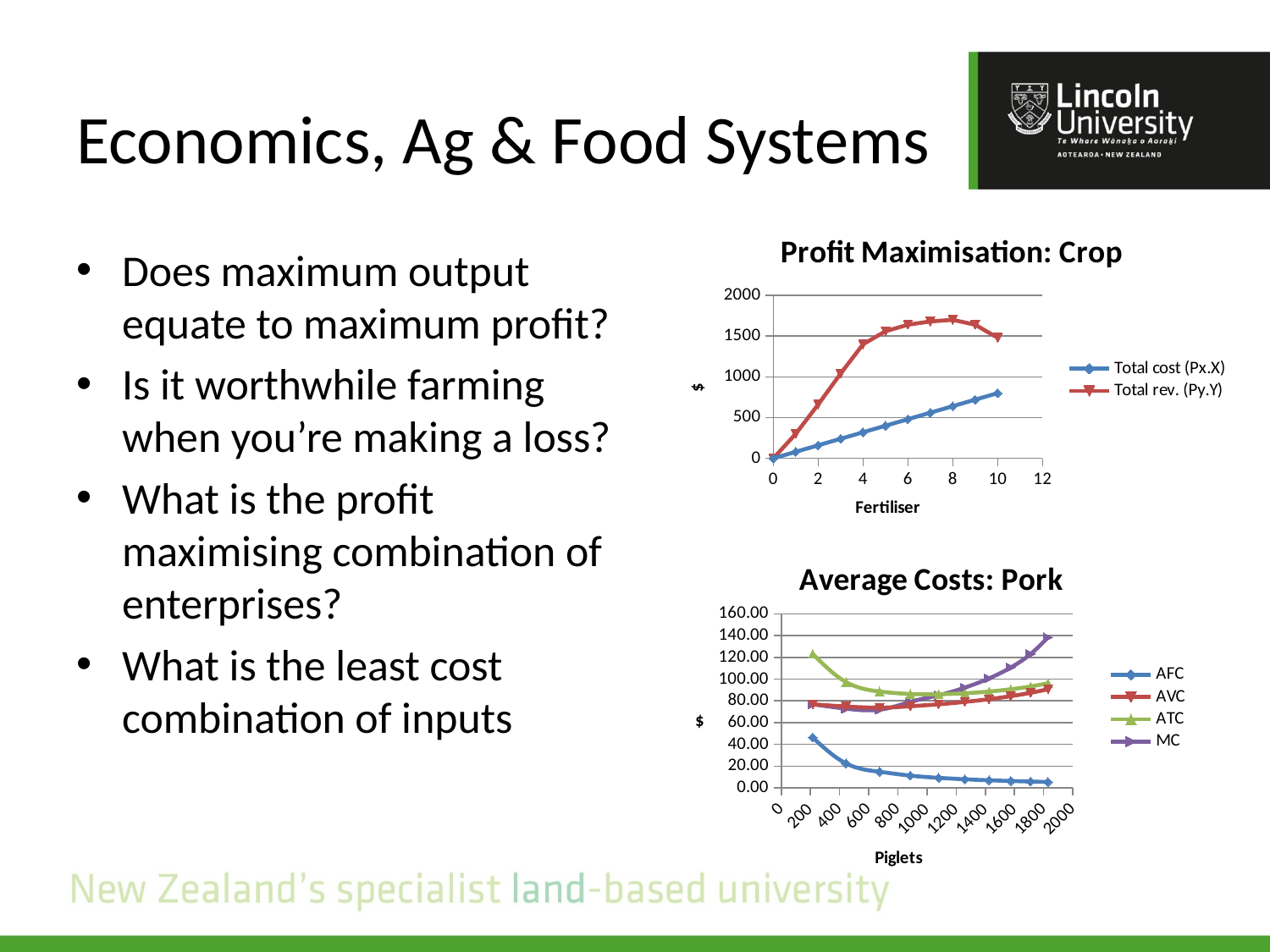
In the 'Profit Maximisation: Crop' chart, is the Total rev. (Py.Y) value at fertiliser 8 greater or less than 1500? greater What kind of chart is the 'Profit Maximisation: Crop' chart? line chart In the 'Average Costs: Pork' chart, is the MC value at 1800 piglets greater or less than 120.00? greater In the 'Profit Maximisation: Crop' chart, which series has the larger value at fertiliser 10, Total cost (Px.X) or Total rev. (Py.Y)? Total rev. (Py.Y) What is the x-axis title of the 'Profit Maximisation: Crop' chart? Fertiliser How many series does the legend of the 'Profit Maximisation: Crop' chart list? 2 In the 'Average Costs: Pork' chart, does the AFC series rise or fall as the number of piglets increases? fall In the 'Profit Maximisation: Crop' chart, does the Total cost (Px.X) series rise or fall as fertiliser increases? rise In the 'Average Costs: Pork' chart, is the ATC value at 200 piglets greater or less than 100.00? greater How many series does the legend of the 'Average Costs: Pork' chart list? 4 In the 'Average Costs: Pork' chart, which series has the larger value at 1800 piglets, MC or AVC? MC